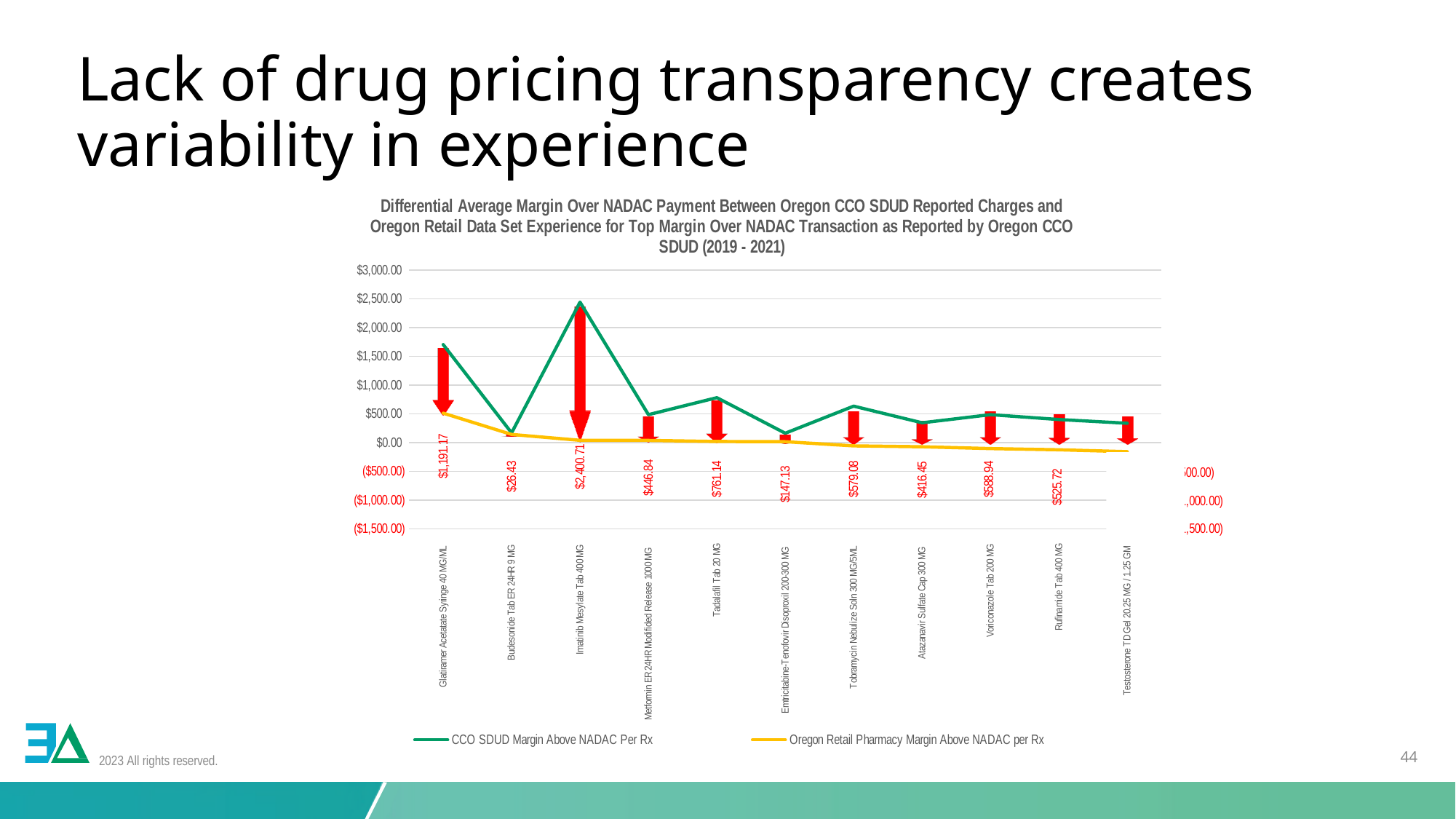
What differential value is labelled for Imatinib Mesylate Tab 400 MG? $2,400.71 What type of chart is shown on the slide? combination bar and line chart What differential value is labelled for Budesonide Tab ER 24HR 9 MG? $26.43 Which has the larger labelled differential value, Tadalafil Tab 20 MG or Tobramycin Nebulize Soln 300 MG/5ML? Tadalafil Tab 20 MG Does the Oregon Retail Pharmacy Margin Above NADAC per Rx line generally rise or fall from left to right across the drugs? fall What differential value is labelled for Glatiramer Acetate Syringe 40 MG/ML? $1,191.17 Which drug has the largest labelled differential value? Imatinib Mesylate Tab 400 MG How many series does the chart legend list? 2 What is the difference between the labelled differential values for Imatinib Mesylate Tab 400 MG and Glatiramer Acetate Syringe 40 MG/ML? $1,209.54 Is the CCO SDUD Margin Above NADAC Per Rx value for Imatinib Mesylate Tab 400 MG greater or less than $2,000.00? greater How many drug categories are plotted along the x axis? 11 Which drug has the smallest labelled differential value? Budesonide Tab ER 24HR 9 MG